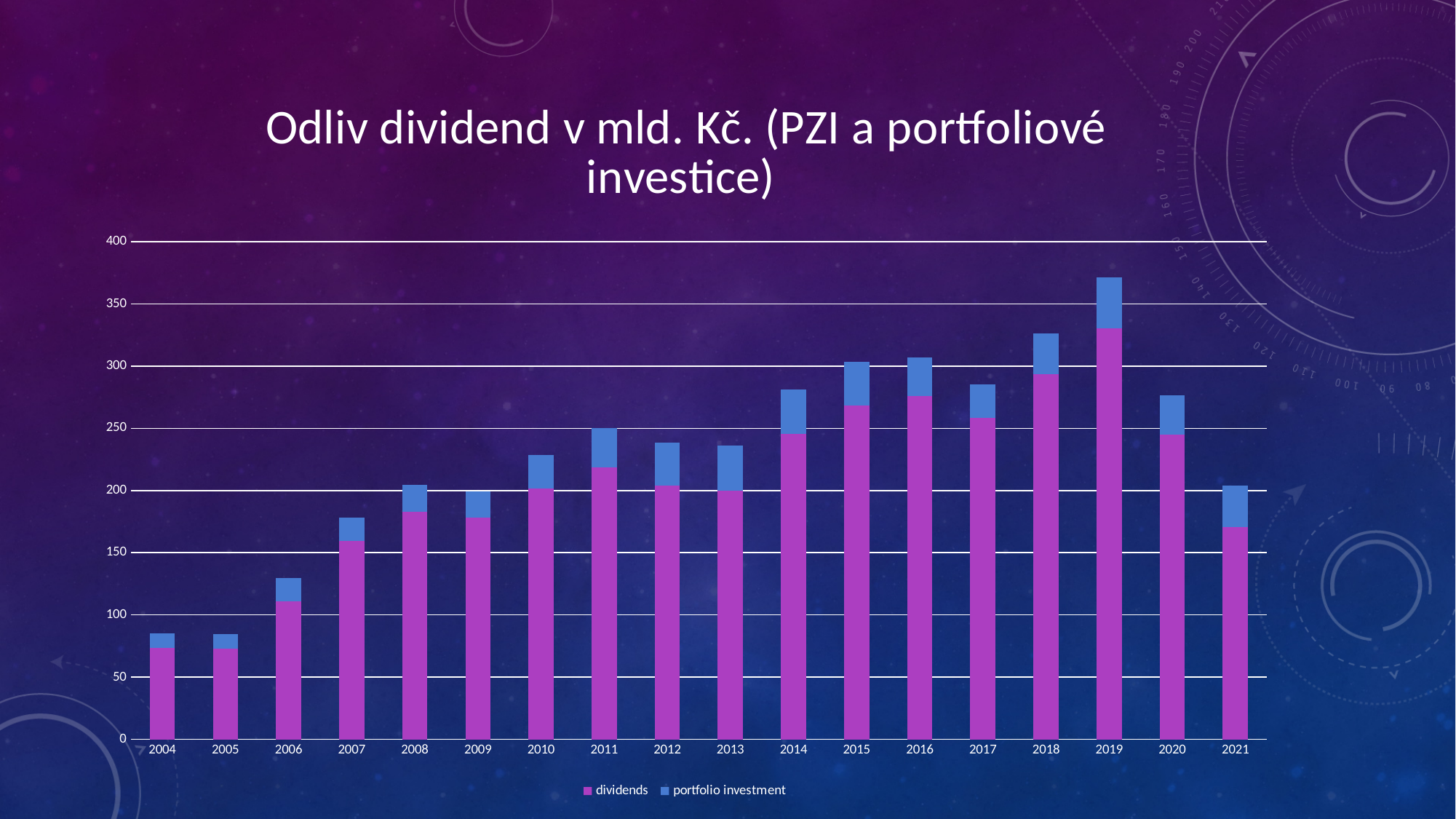
Do the total bars generally rise or fall from 2004 to 2011? rise Which series is shown in blue in the legend? portfolio investment Which year has the highest total bar? 2019 Is the total value for 2004 greater or less than 100? less Which year has the larger total bar, 2017 or 2018? 2018 What kind of chart is shown on the slide? stacked bar chart Is the total value for 2006 greater or less than 150? less Is the dividends value for 2021 greater or less than 200? less How many years are shown on the x axis of the chart? 18 How many series does the legend list? 2